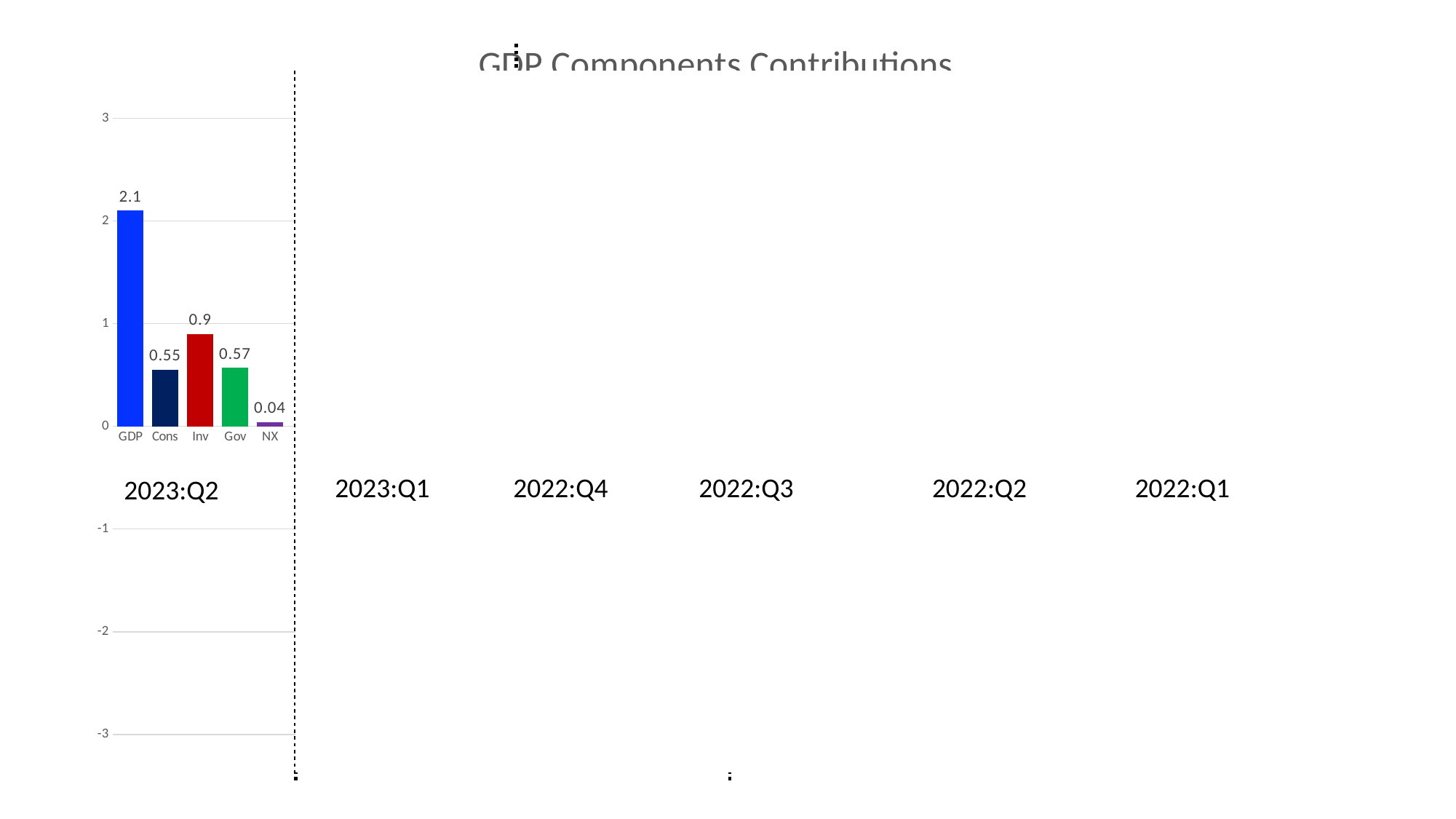
What is the difference between the GDP bar and the Inv bar for 2023:Q2? 1.2 Which is larger for 2023:Q2, the Inv bar or the Cons bar? Inv Which component has the lowest bar in the 2023:Q2 group? NX What is the value of the GDP bar for 2023:Q2? 2.1 What is the value of the Gov bar for 2023:Q2? 0.57 What is the value of the Inv bar for 2023:Q2? 0.9 Which component has the highest bar in the 2023:Q2 group? GDP How many bars are plotted in the 2023:Q2 group? 5 What type of chart is shown on the slide? Bar chart What is the value of the Cons bar for 2023:Q2? 0.55 What is the value of the NX bar for 2023:Q2? 0.04 Is the value of the GDP bar for 2023:Q2 greater or less than 2? greater